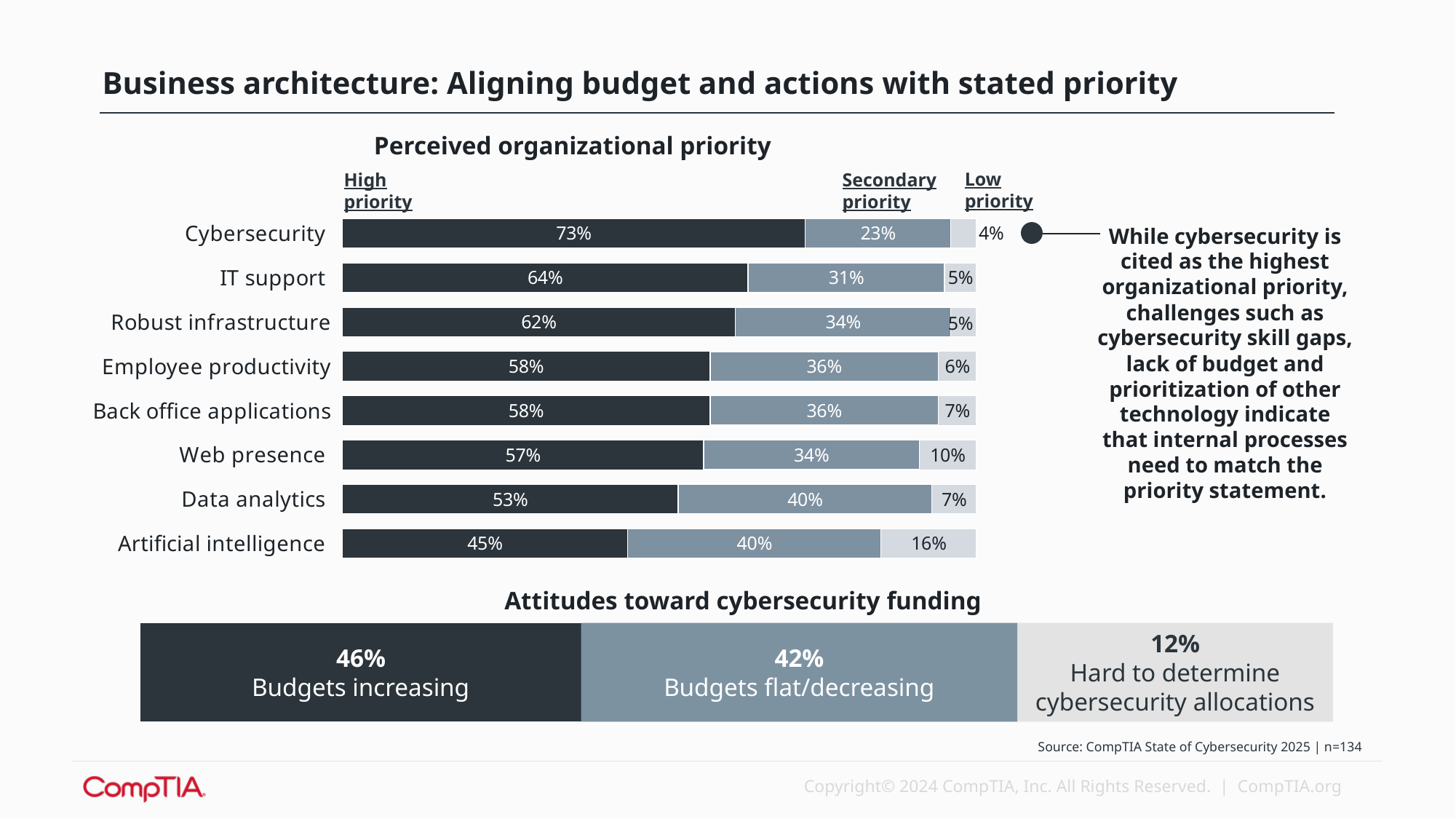
In the 'Perceived organizational priority' chart, what percentage rate Cybersecurity as a high priority? 73% How many series does the 'Perceived organizational priority' chart show? 3 In the 'Perceived organizational priority' chart, which category has the lowest high priority value? Artificial intelligence In the 'Perceived organizational priority' chart, what is the difference between the high priority values for Cybersecurity and IT support? 9% How many categories are shown in the 'Perceived organizational priority' chart? 8 In the 'Perceived organizational priority' chart, which category has the highest high priority value? Cybersecurity What kind of chart is the 'Perceived organizational priority' chart? Stacked bar chart In the 'Attitudes toward cybersecurity funding' chart, what percentage report budgets increasing? 46% In the 'Perceived organizational priority' chart, what is the secondary priority value for Data analytics? 40% In the 'Perceived organizational priority' chart, what is the low priority value for Artificial intelligence? 16% In the 'Perceived organizational priority' chart, which has a larger low priority value, Web presence or Data analytics? Web presence In the 'Attitudes toward cybersecurity funding' chart, what is the difference between 'Budgets increasing' and 'Budgets flat/decreasing'? 4%